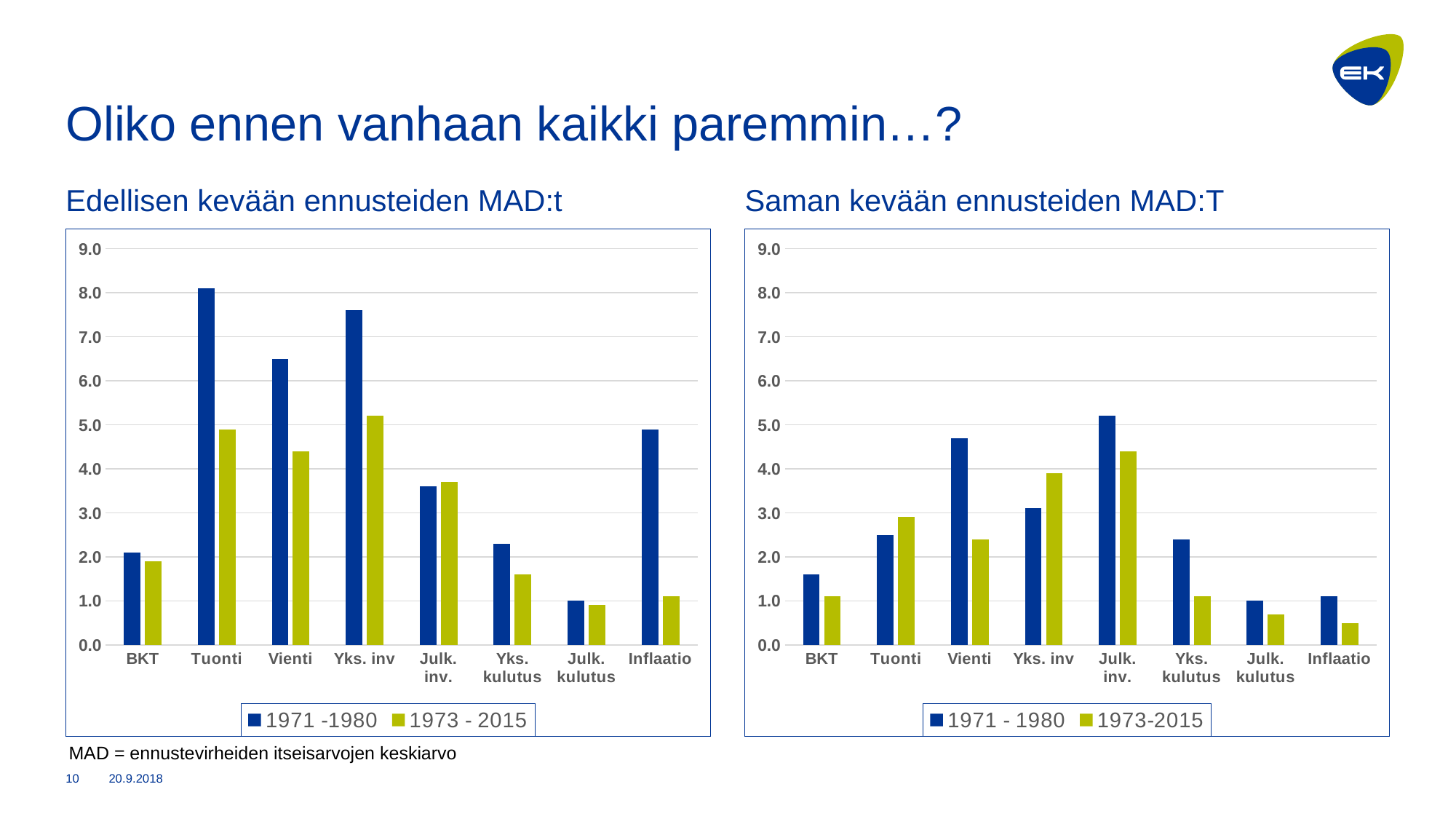
On the right chart (Saman kevään ennusteiden MAD:T), for Yks. inv, which series has the larger value: 1971 - 1980 or 1973-2015? 1973-2015 On the left chart (Edellisen kevään ennusteiden MAD:t), is the 1971 -1980 value for Tuonti greater or less than 7.0? greater On the right chart (Saman kevään ennusteiden MAD:T), is the 1971 - 1980 value for Vienti greater or less than 4.0? greater On the left chart (Edellisen kevään ennusteiden MAD:t), how many categories are shown on the x axis? 8 On the right chart (Saman kevään ennusteiden MAD:T), which category has the highest value for the 1971 - 1980 series? Julk. inv. On the left chart (Edellisen kevään ennusteiden MAD:t), for Inflaatio, which series has the larger value: 1971 -1980 or 1973 - 2015? 1971 -1980 On the left chart (Edellisen kevään ennusteiden MAD:t), which category has the highest value for the 1971 -1980 series? Tuonti On the left chart (Edellisen kevään ennusteiden MAD:t), which category has the lowest value for the 1971 -1980 series? Julk. kulutus On the left chart (Edellisen kevään ennusteiden MAD:t), how many series does the legend list? 2 On the left chart (Edellisen kevään ennusteiden MAD:t), what kind of chart is shown? bar chart On the right chart (Saman kevään ennusteiden MAD:T), what are the two legend entries? 1971 - 1980 and 1973-2015 On the right chart (Saman kevään ennusteiden MAD:T), which category has the lowest value for the 1973-2015 series? Inflaatio